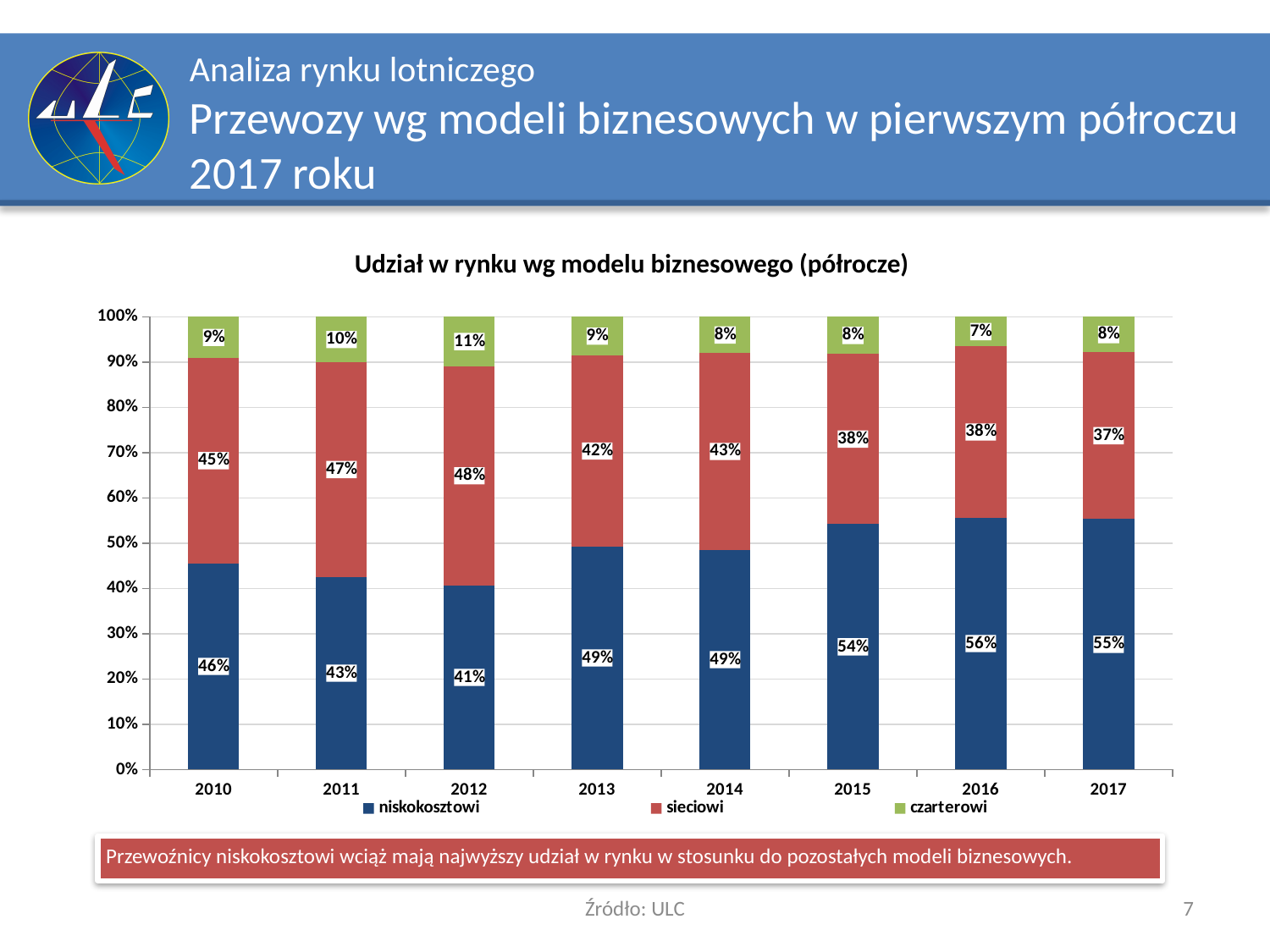
What is the difference between the niskokosztowi share in 2016 and in 2010? 10 percentage points What is the value for sieciowi in 2012? 48% What kind of chart is shown on the slide? Stacked bar chart How many years are shown on the x axis? 8 What is the title of the chart? Udział w rynku wg modelu biznesowego (półrocze) Does the sieciowi share rise or fall from 2012 to 2017? Fall What is the value for czarterowi in 2011? 10% Which is larger in 2012: the niskokosztowi share or the sieciowi share? sieciowi How many series does the legend list? 3 In which year is the czarterowi share lowest? 2016 In which year is the niskokosztowi share highest? 2016 What is the value for niskokosztowi in 2017? 55%